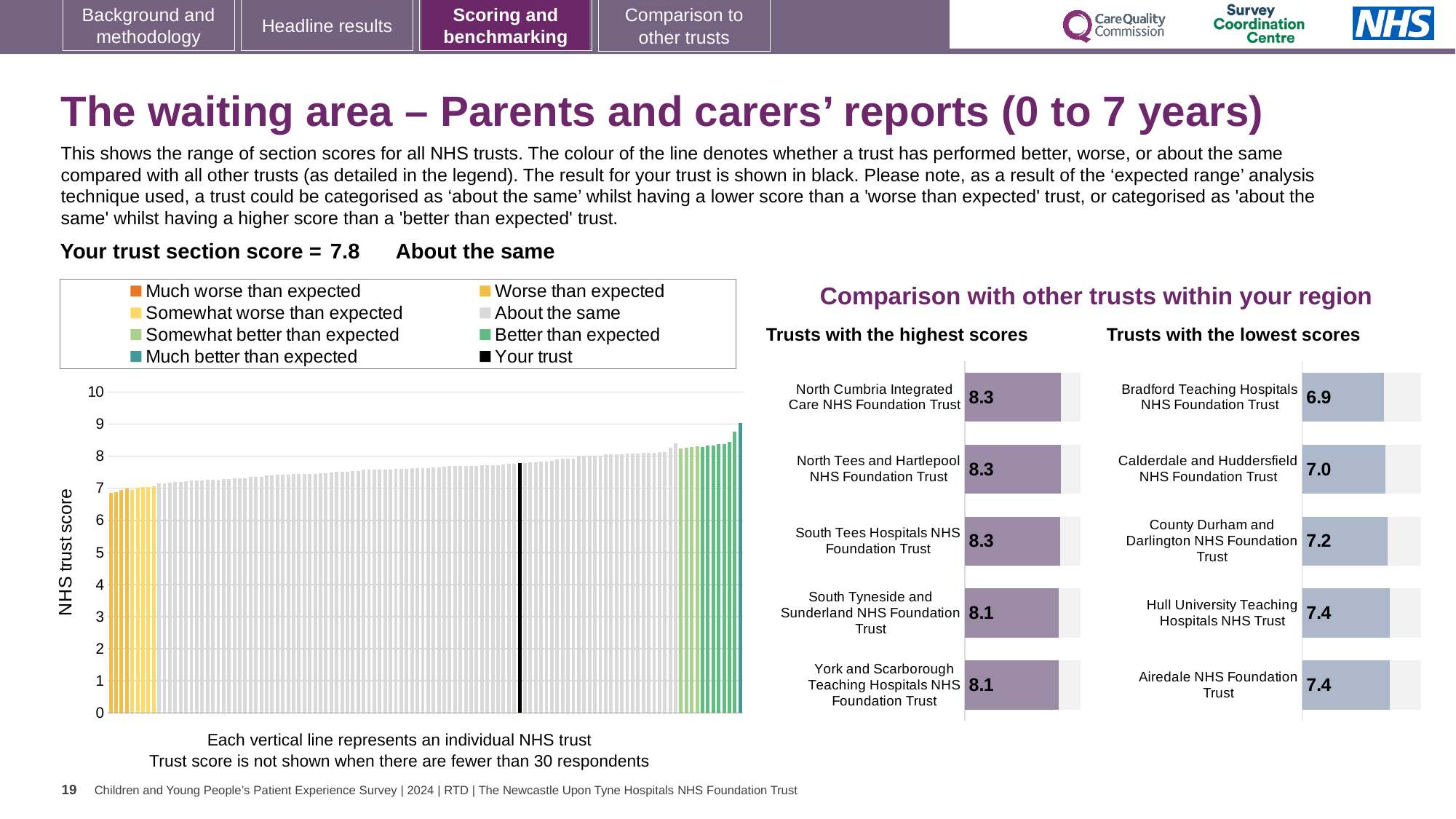
How many entries does the legend above the large chart on the left list? 8 In the 'Trusts with the highest scores' chart, what is the score for North Cumbria Integrated Care NHS Foundation Trust? 8.3 In the 'Trusts with the lowest scores' chart, which trust has the lowest score? Bradford Teaching Hospitals NHS Foundation Trust In the large chart on the left, do the trust scores rise or fall from left to right? Rise In the 'Trusts with the lowest scores' chart, which has the higher score: Calderdale and Huddersfield NHS Foundation Trust or County Durham and Darlington NHS Foundation Trust? County Durham and Darlington NHS Foundation Trust In the 'Trusts with the highest scores' chart, what is the score for South Tyneside and Sunderland NHS Foundation Trust? 8.1 How many trusts are shown in the 'Trusts with the highest scores' chart? 5 In the 'Trusts with the lowest scores' chart, what is the score for Calderdale and Huddersfield NHS Foundation Trust? 7.0 What kind of chart is the large chart on the left showing NHS trust scores? Bar chart In the 'Trusts with the lowest scores' chart, what is the difference between the scores of Hull University Teaching Hospitals NHS Trust and Bradford Teaching Hospitals NHS Foundation Trust? 0.5 In the large chart on the left, is the value of the black bar (your trust) greater or less than 7? greater In the 'Trusts with the highest scores' chart, what is the difference between the scores of North Tees and Hartlepool NHS Foundation Trust and York and Scarborough Teaching Hospitals NHS Foundation Trust? 0.2